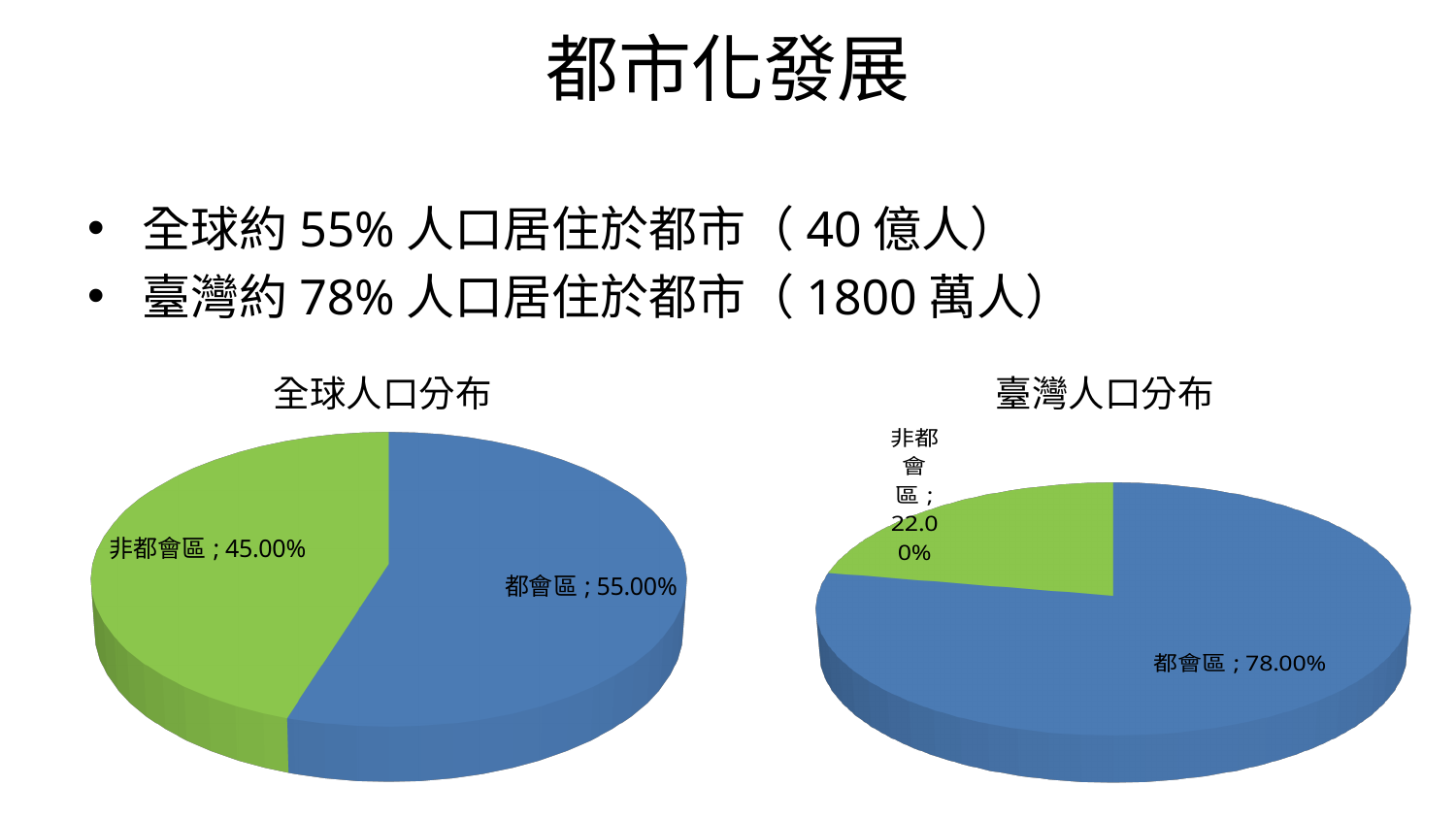
In the 臺灣人口分布 chart, what is the difference between 都會區 and 非都會區? 56.00% In the 全球人口分布 chart, what colour is the 非都會區 slice? Green In the 臺灣人口分布 chart, what is the value for 非都會區? 22.00% In the 全球人口分布 chart, what is the value for 都會區? 55.00% In the 全球人口分布 chart, what is the value for 非都會區? 45.00% How many slices does the 臺灣人口分布 chart have? 2 In the 全球人口分布 chart, what is the difference between 都會區 and 非都會區? 10.00% Which is larger: 都會區 in the 全球人口分布 chart or 都會區 in the 臺灣人口分布 chart? 都會區 in the 臺灣人口分布 chart In the 臺灣人口分布 chart, what is the value for 都會區? 78.00% In the 全球人口分布 chart, which slice is the smallest? 非都會區 What kind of chart is the 全球人口分布 chart? Pie chart In the 臺灣人口分布 chart, which slice is the largest? 都會區